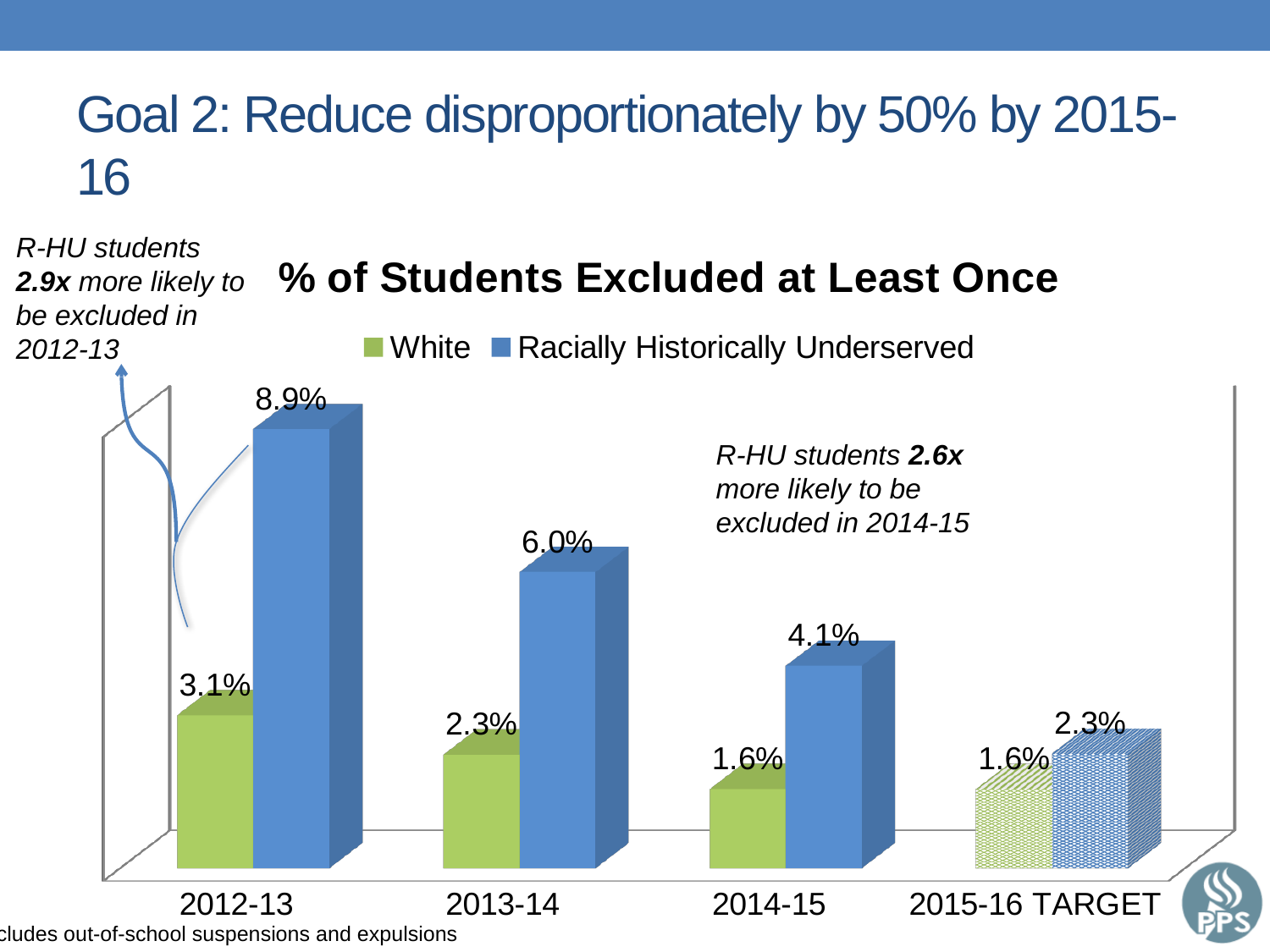
What is the value for Racially Historically Underserved students in 2014-15? 4.1% How many series does the legend list? 2 What is the difference between the Racially Historically Underserved and White values in 2012-13? 5.8% Do the values for Racially Historically Underserved students rise or fall from 2012-13 to 2015-16 TARGET? Fall In which year is the value for Racially Historically Underserved students highest? 2012-13 What kind of chart is shown? Bar chart What is the 2015-16 TARGET value for White students? 1.6% Which category has the lowest value for Racially Historically Underserved students? 2015-16 TARGET Which is larger in 2013-14: the White value or the Racially Historically Underserved value? Racially Historically Underserved How many categories are shown on the x axis? 4 What is the value for White students in 2013-14? 2.3% What is the value for Racially Historically Underserved students in 2012-13? 8.9%